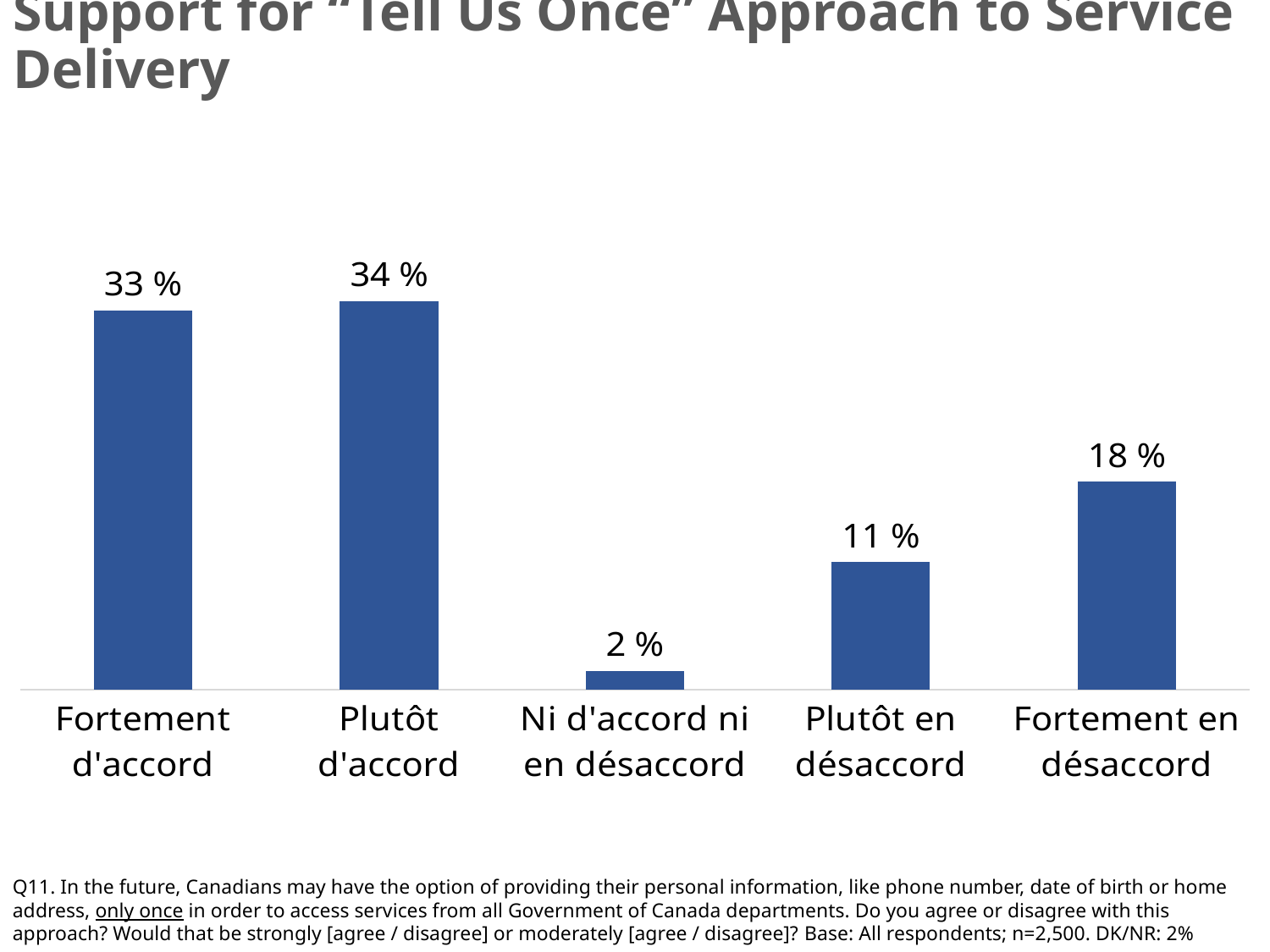
What is the value for "Fortement en désaccord"? 18 % Which category has the lowest value? Ni d'accord ni en désaccord Which is larger, the value for "Fortement d'accord" or the value for "Fortement en désaccord"? Fortement d'accord What is the combined value of "Fortement d'accord" and "Plutôt d'accord"? 67 % What is the difference between the values for "Fortement en désaccord" and "Plutôt en désaccord"? 7 % What is the value for "Fortement d'accord"? 33 % How many categories are shown on the x axis? 5 What kind of chart is shown on the slide? Bar chart What is the value for "Plutôt d'accord"? 34 % What is the value for "Plutôt en désaccord"? 11 % What is the value for "Ni d'accord ni en désaccord"? 2 % Which category has the highest value? Plutôt d'accord